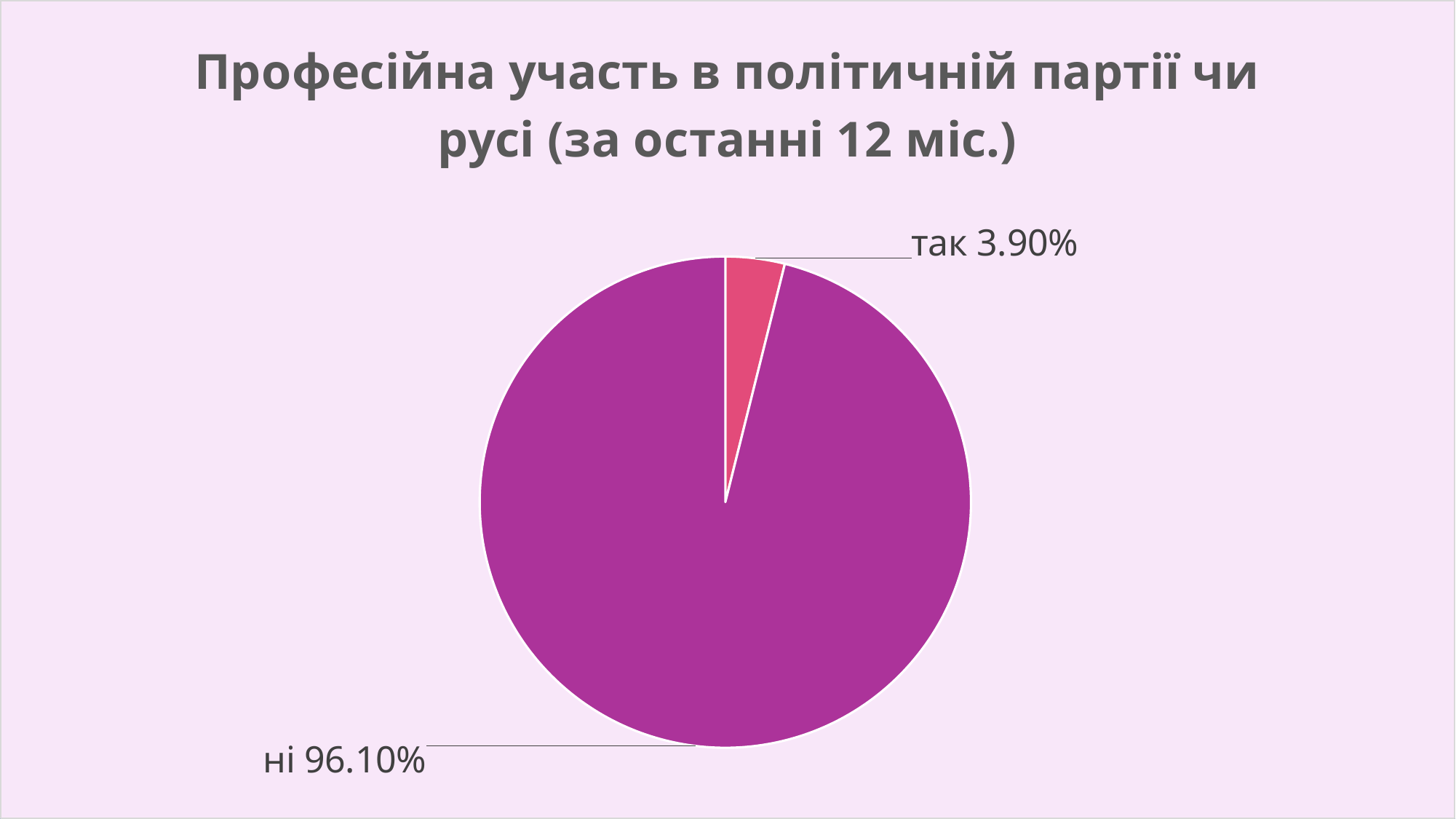
Which category has the smallest share of the pie? так Which category has the largest share of the pie? ні What is the value for "так"? 3.90% How many slices does the pie chart have? 2 What is the title of the chart? Професійна участь в політичній партії чи русі (за останні 12 міс.) Which is larger, the value for "так" or the value for "ні"? ні What is the value for "ні"? 96.10% What share of the pie does the "так" slice represent? 3.90% What type of chart is shown on the slide? pie chart What colour is the "так" slice? pink What is the difference between the values for "ні" and "так"? 92.20%